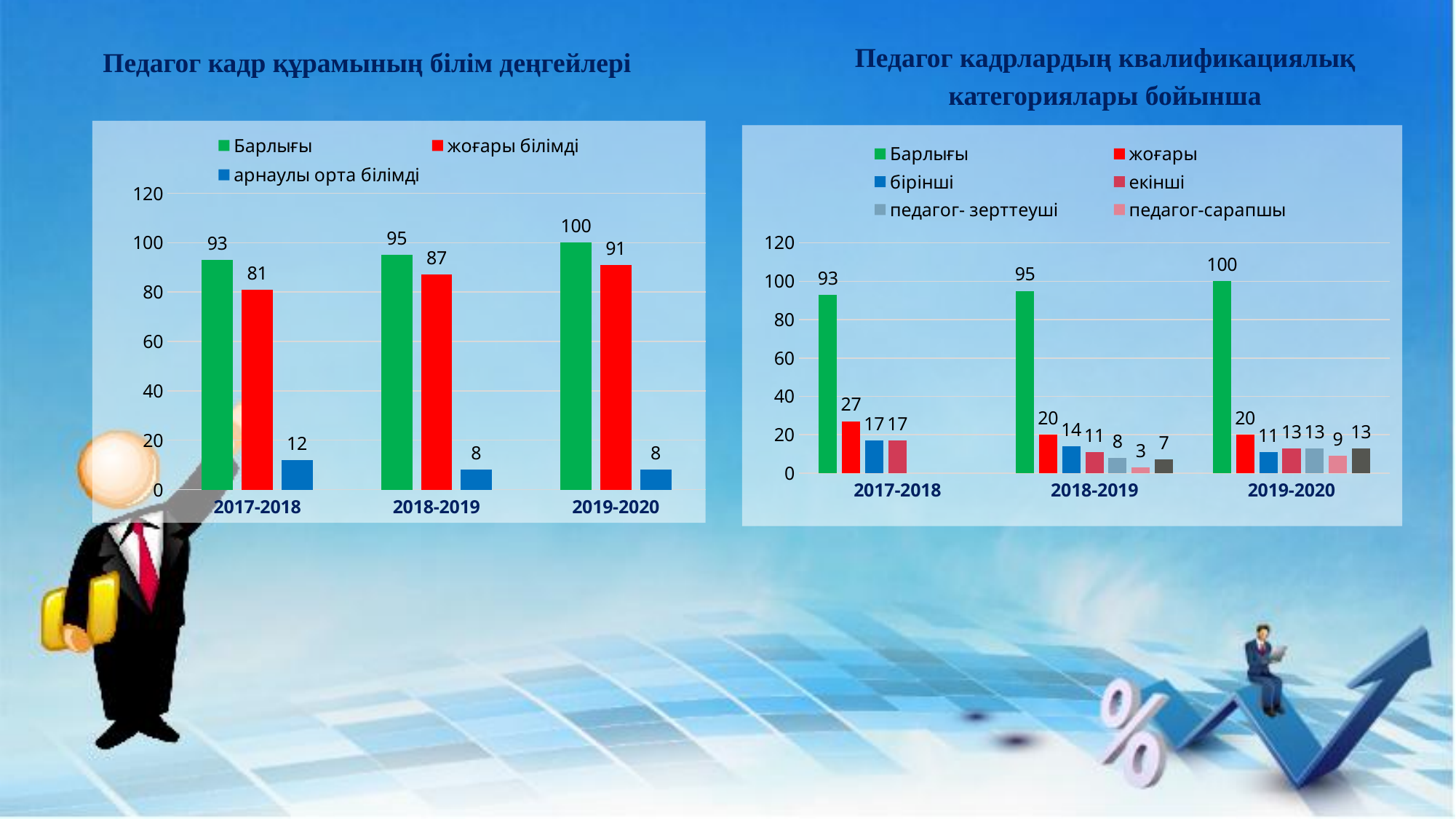
In the left chart (Педагог кадр құрамының білім деңгейлері), how many series does the legend list? 3 What type of chart is the right chart (Педагог кадрлардың квалификациялық категориялары бойынша)? bar chart In the right chart (Педагог кадрлардың квалификациялық категориялары бойынша), which is larger in 2018-2019: бірінші or екінші? бірінші In the right chart (Педагог кадрлардың квалификациялық категориялары бойынша), what is the value of жоғары for 2017-2018? 27 In the right chart (Педагог кадрлардың квалификациялық категориялары бойынша), how many series does the legend list? 6 In the left chart (Педагог кадр құрамының білім деңгейлері), how many year categories are shown on the x axis? 3 In the left chart (Педагог кадр құрамының білім деңгейлері), what is the difference between Барлығы and жоғары білімді in 2019-2020? 9 In the right chart (Педагог кадрлардың квалификациялық категориялары бойынша), what is the value of педагог-сарапшы for 2018-2019? 3 In the left chart (Педагог кадр құрамының білім деңгейлері), what is the value of арнаулы орта білімді for 2017-2018? 12 In the left chart (Педагог кадр құрамының білім деңгейлері), what is the value of жоғары білімді for 2018-2019? 87 In the left chart (Педагог кадр құрамының білім деңгейлері), does the value of жоғары білімді rise or fall from 2017-2018 to 2019-2020? rise In the right chart (Педагог кадрлардың квалификациялық категориялары бойынша), which year has the highest Барлығы value? 2019-2020